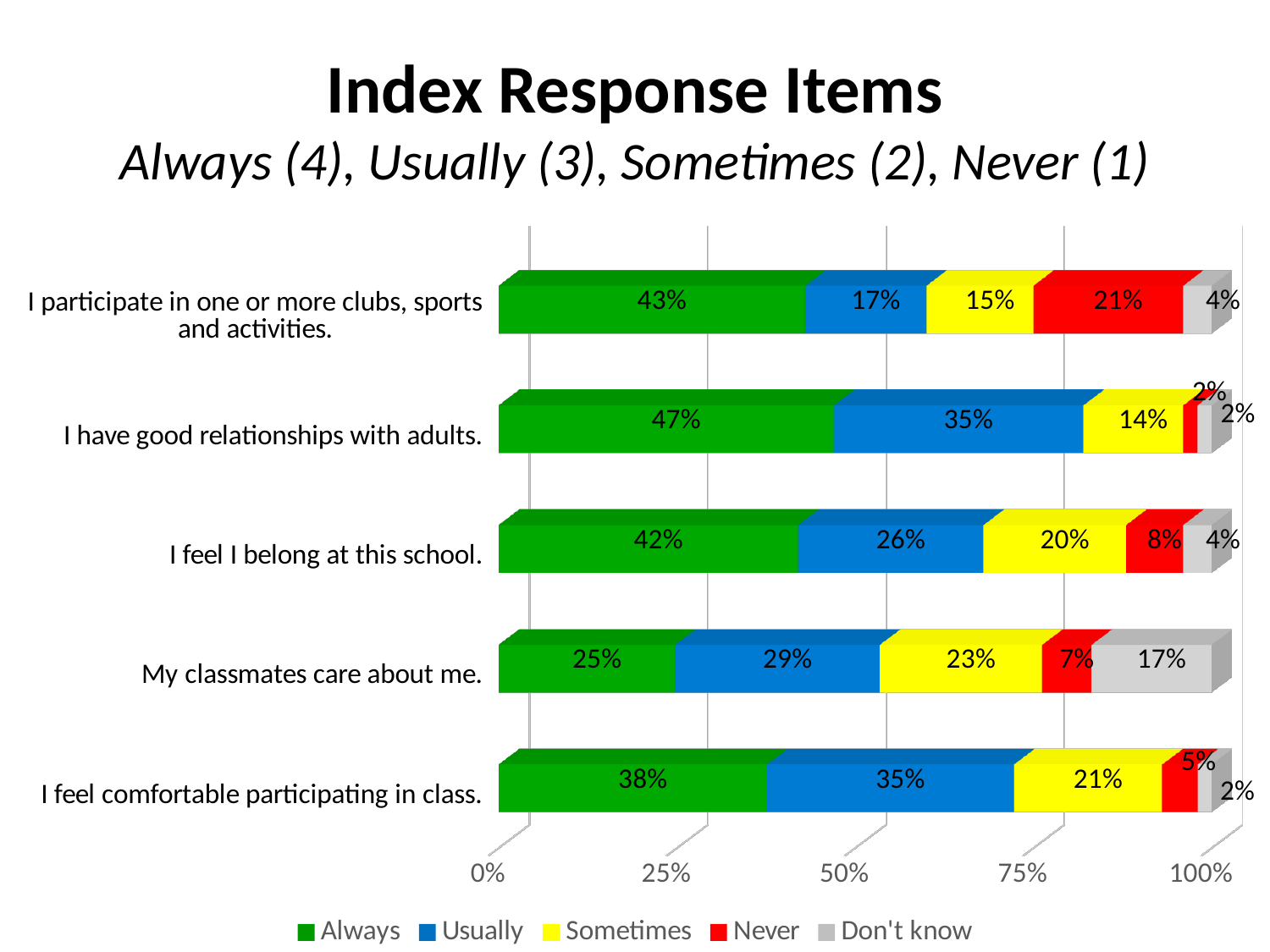
What is the difference between the "Usually" values for "I feel I belong at this school." and "I participate in one or more clubs, sports and activities."? 9% What percentage answered "Don't know" for "My classmates care about me."? 17% What is the "Never" value for "I participate in one or more clubs, sports and activities."? 21% How many series does the legend list? 5 Which item has the lowest "Always" percentage? My classmates care about me. How many response items are shown in the chart? 5 What percentage of respondents answered "Always" to "I have good relationships with adults."? 47% What is the total of the stacked bar for "I participate in one or more clubs, sports and activities."? 100% Which item has the highest "Always" percentage? I have good relationships with adults. What kind of chart is shown on the slide? Stacked bar chart What is the "Sometimes" value for "I feel I belong at this school."? 20% Which has a larger "Never" value: "I feel I belong at this school." or "I feel comfortable participating in class."? I feel I belong at this school.